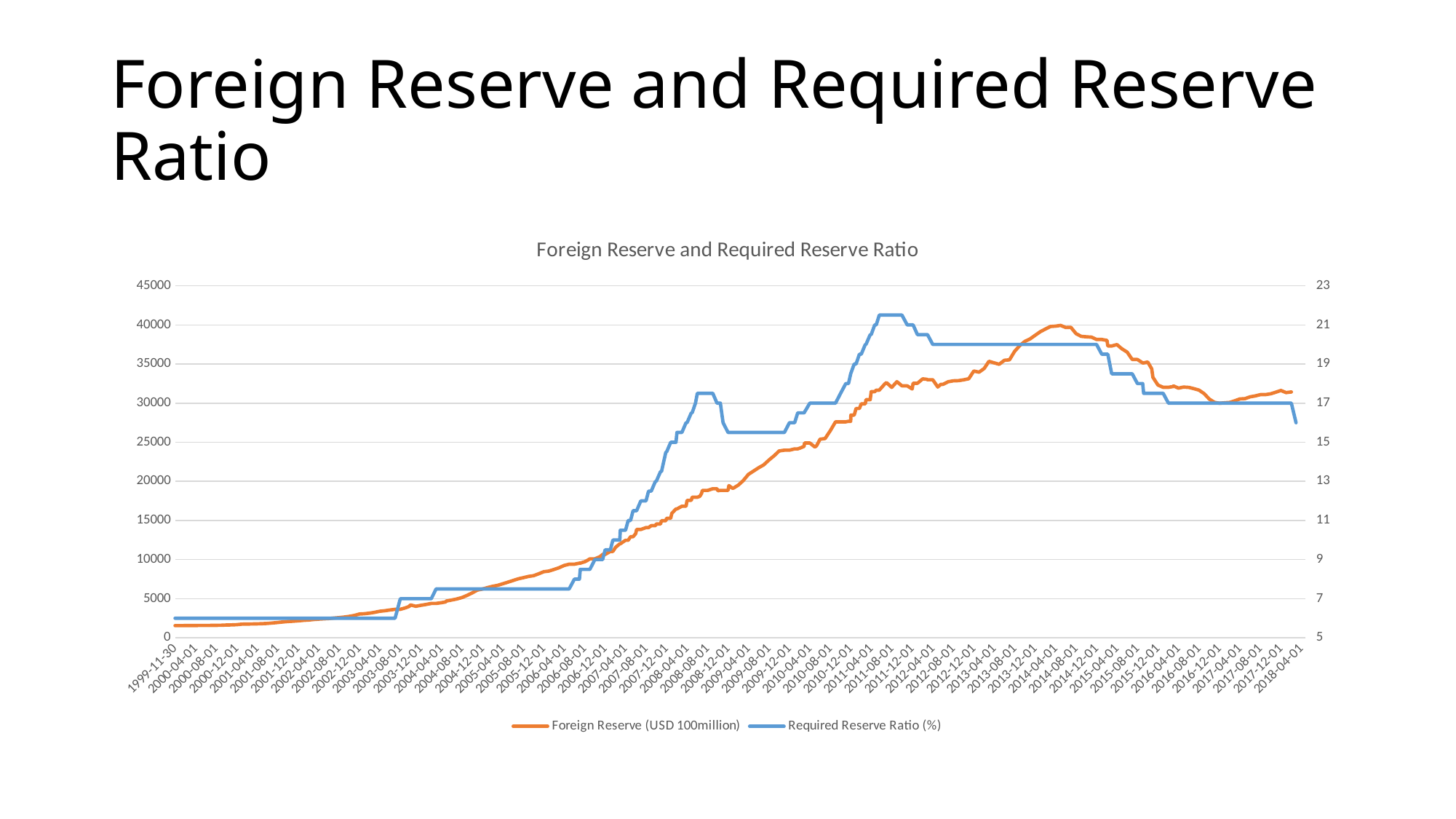
Is the Required Reserve Ratio (%) value at 2011-08-01 greater or less than 19? greater Does the Required Reserve Ratio (%) line rise or fall between 2015-04-01 and 2018-04-01? Fall Is the Foreign Reserve (USD 100million) value at 2010-04-01 greater or less than 20000? greater Is the Foreign Reserve (USD 100million) value at 2014-08-01 greater or less than 35000? greater In which year does the Required Reserve Ratio (%) line reach its highest level? 2011 How many series does the legend list? 2 Does the Foreign Reserve (USD 100million) line rise or fall between 1999-11-30 and 2014-04-01? Rise Which colour is used for the Required Reserve Ratio (%) line? Blue What is the title of the chart? Foreign Reserve and Required Reserve Ratio What kind of chart is shown on the slide? Line chart What is the Required Reserve Ratio (%) value in 2017-04-01? 17